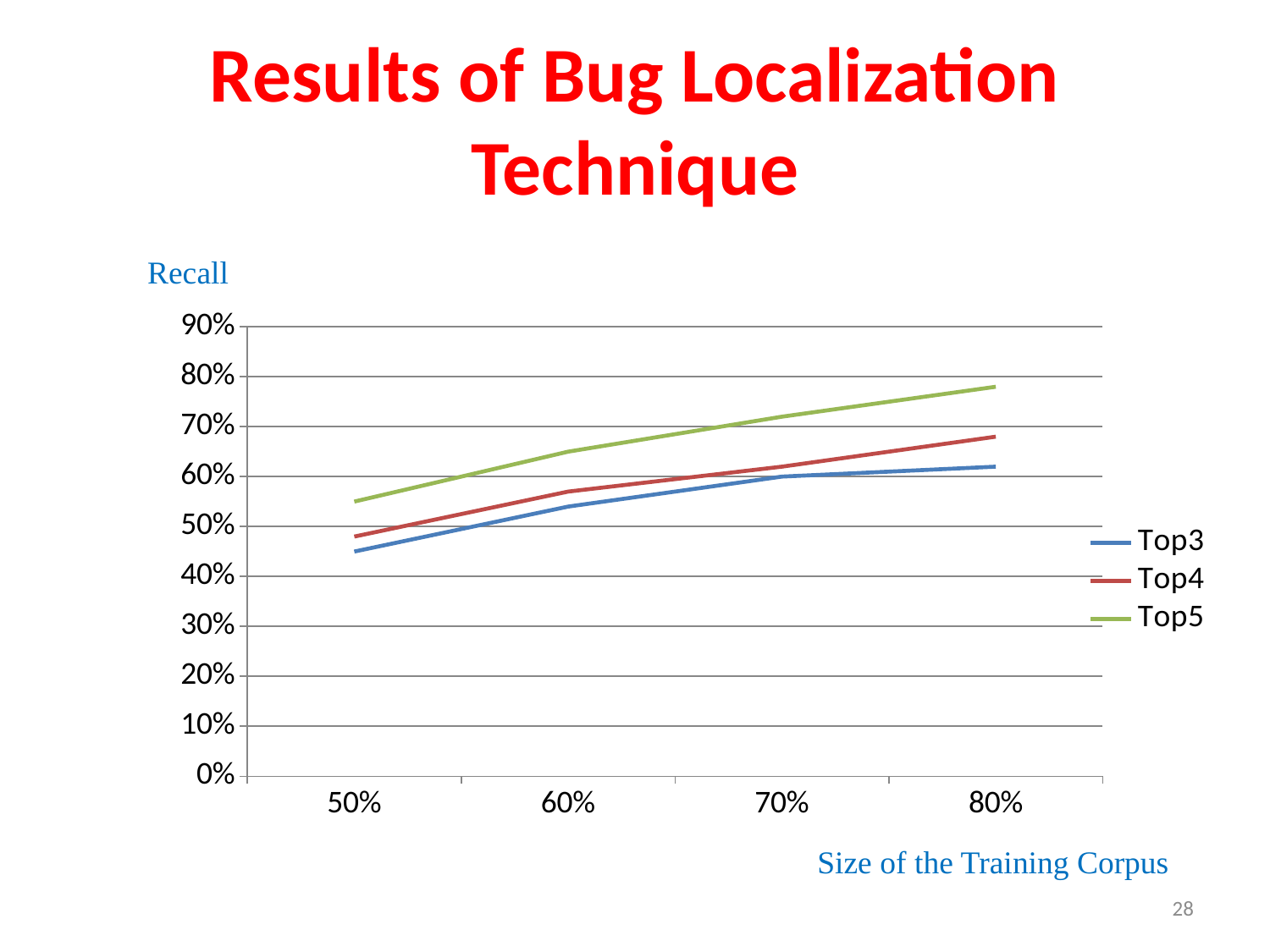
Which series has the lowest recall at a training corpus size of 50%? Top3 Do the recall values for Top5 rise or fall as the size of the training corpus increases? rise Which series has the highest recall at a training corpus size of 80%? Top5 What is the label of the x axis? Size of the Training Corpus Is the Top4 recall at a training corpus size of 80% greater or less than 60%? greater How many training corpus sizes are plotted along the x axis? 4 What kind of chart is shown on the slide? line chart Is the Top5 recall at a training corpus size of 50% greater or less than 50%? greater At a training corpus size of 80%, which has the higher recall, Top3 or Top5? Top5 How many series does the legend list? 3 Is the Top3 recall at a training corpus size of 50% greater or less than 50%? less